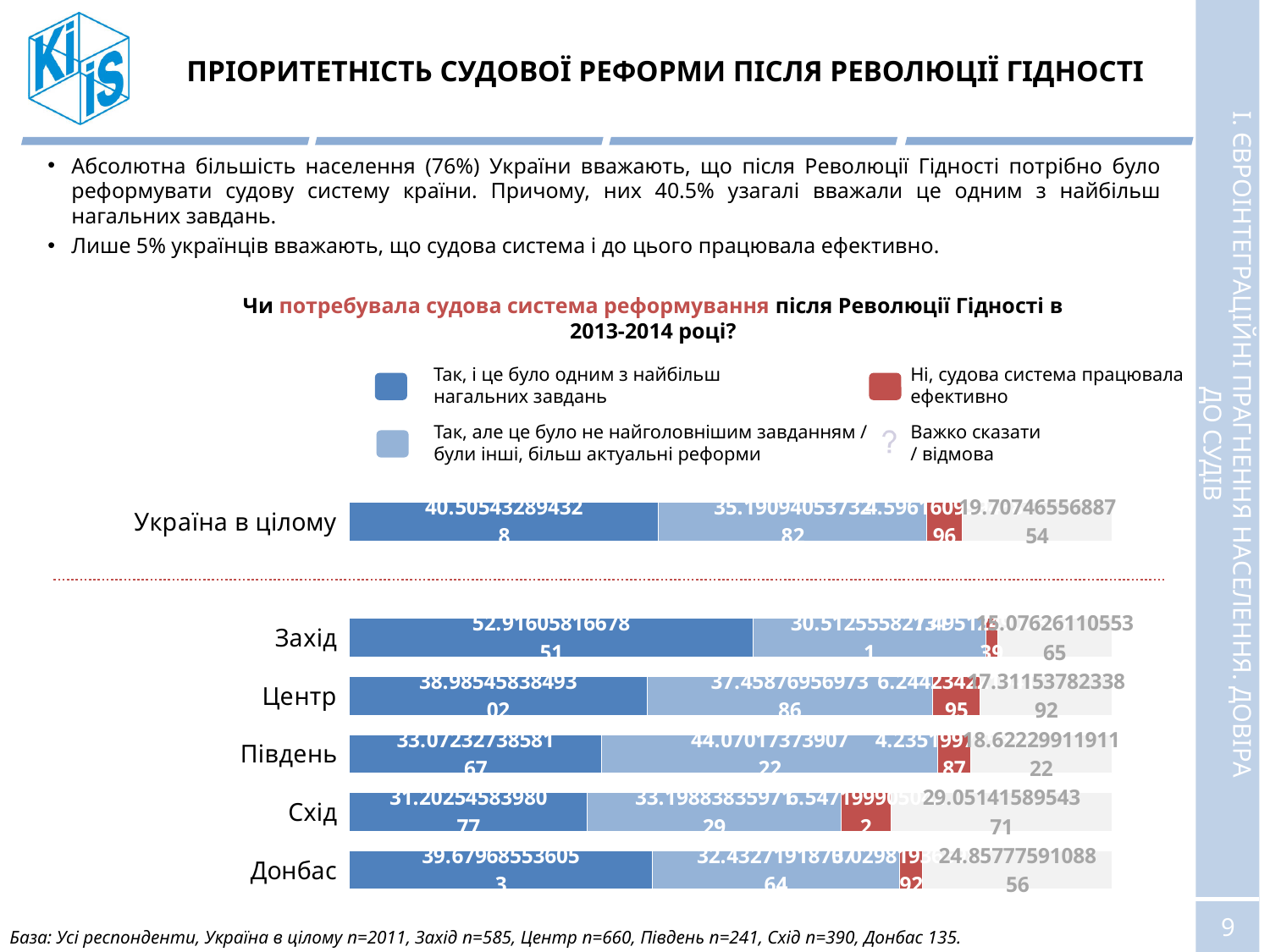
How many categories (rows) are plotted in the chart? 6 For 'Так, але це було не найголовнішим завданням / були інші, більш актуальні реформи', which is larger: Південь or Захід? Південь Which category has the smallest share for 'Важко сказати / відмова'? Захід For 'Так, і це було одним з найбільш нагальних завдань', which is larger: Захід or Центр? Захід What colour represents 'Ні, судова система працювала ефективно' in the chart? red Which category has the largest share for 'Так, але це було не найголовнішим завданням / були інші, більш актуальні реформи'? Південь What kind of chart is shown on the slide? bar chart For 'Важко сказати / відмова', which is larger: Схід or Захід? Схід Which category has the largest share for 'Важко сказати / відмова'? Схід Which category is shown separately at the top of the chart, above the dotted line? Україна в цілому Which category has the largest share for 'Так, і це було одним з найбільш нагальних завдань'? Захід How many series does the chart legend list? 4